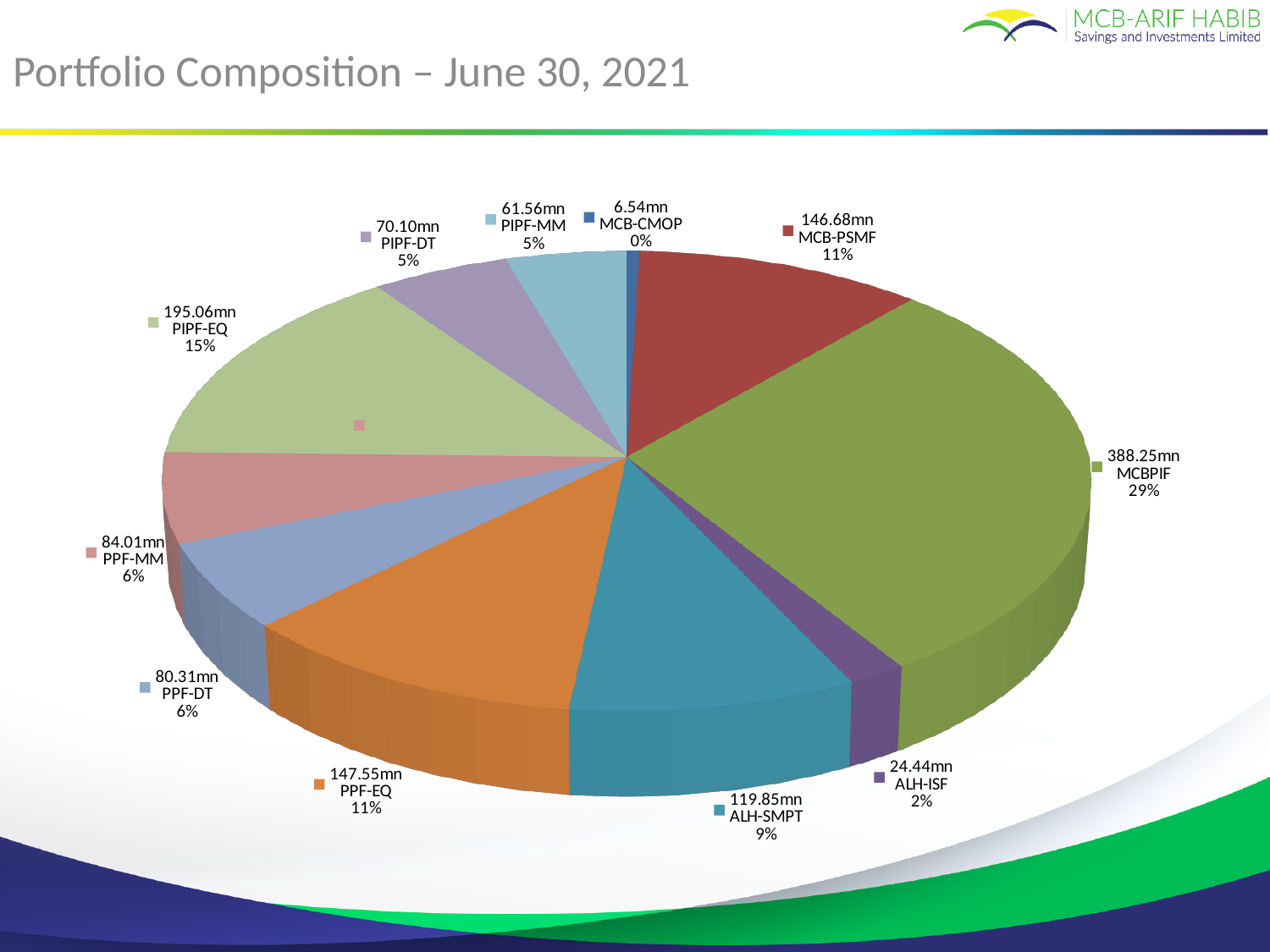
What percentage share is shown for PIPF-EQ? 15% Which is larger, PIPF-EQ or PPF-EQ? PIPF-EQ What is the value shown for MCBPIF? 388.25mn Which fund has the largest slice of the pie? MCBPIF What percentage share is shown for ALH-ISF? 2% Which fund has the smallest slice of the pie? MCB-CMOP What is the difference between the values for PPF-MM and PPF-DT? 3.70mn What is the difference between the values for MCBPIF and MCB-PSMF? 241.57mn What is the title of the slide? Portfolio Composition – June 30, 2021 What is the value shown for ALH-SMPT? 119.85mn What share of the portfolio does MCBPIF represent? 29% What kind of chart is shown on the slide? Pie chart